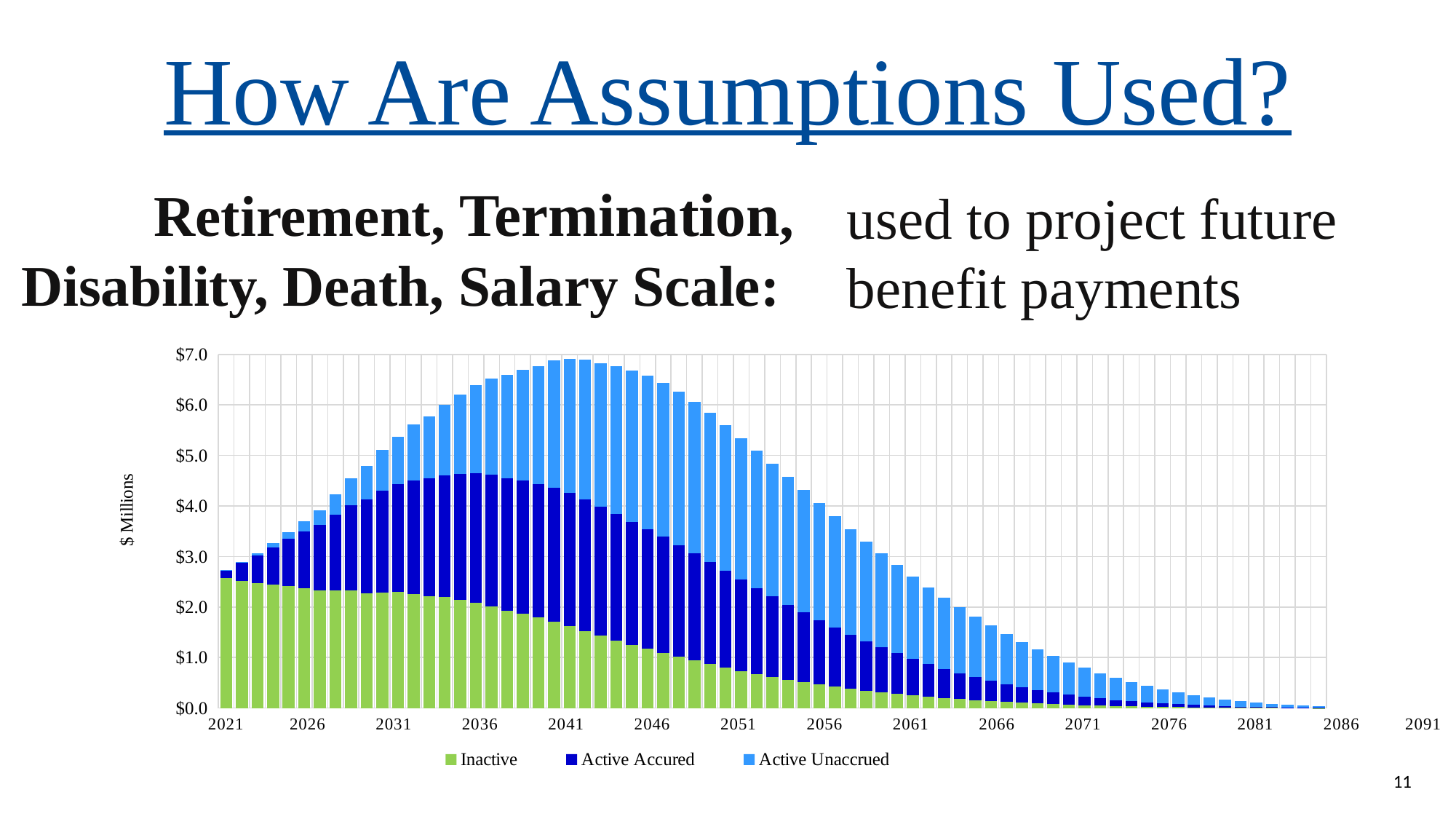
What is the label on the chart's vertical axis? $ Millions Is the total stacked value for 2066 greater or less than $2.0? less Do the total stacked values rise or fall from 2021 to 2041? rise Does the Inactive series rise or fall from 2021 to 2071? fall How many series does the chart's legend list? 3 Is the total stacked value for 2041 greater or less than $6.0? greater What are the three series named in the chart's legend? Inactive, Active Accured, Active Unaccrued What kind of chart is shown on the slide? stacked bar chart Is the total stacked value for 2076 greater or less than $1.0? less Do the total stacked values rise or fall from 2046 to 2086? fall